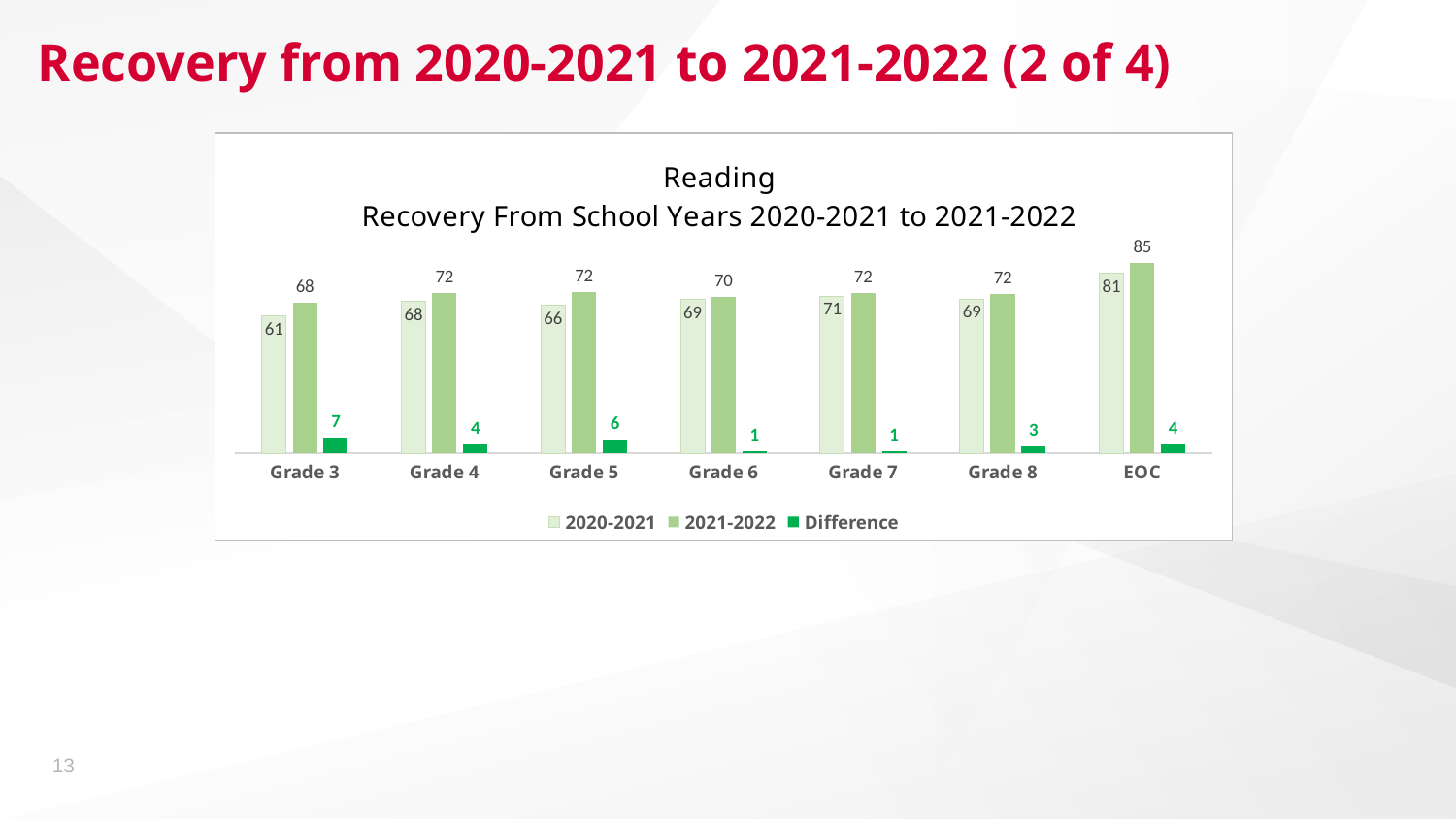
What is the Difference value for Grade 5? 6 Which category has the highest 2021-2022 value? EOC What is the difference between the 2021-2022 and 2020-2021 values for Grade 4? 4 What is the first line of the chart title? Reading Is the 2020-2021 value for Grade 7 larger or smaller than the 2020-2021 value for Grade 8? larger What kind of chart is shown? bar chart What is the 2021-2022 value for EOC? 85 What is the 2020-2021 value for Grade 3? 61 Which category has the lowest 2020-2021 value? Grade 3 Which category has the largest Difference value? Grade 3 How many series does the legend list? 3 How many categories are shown on the x axis? 7